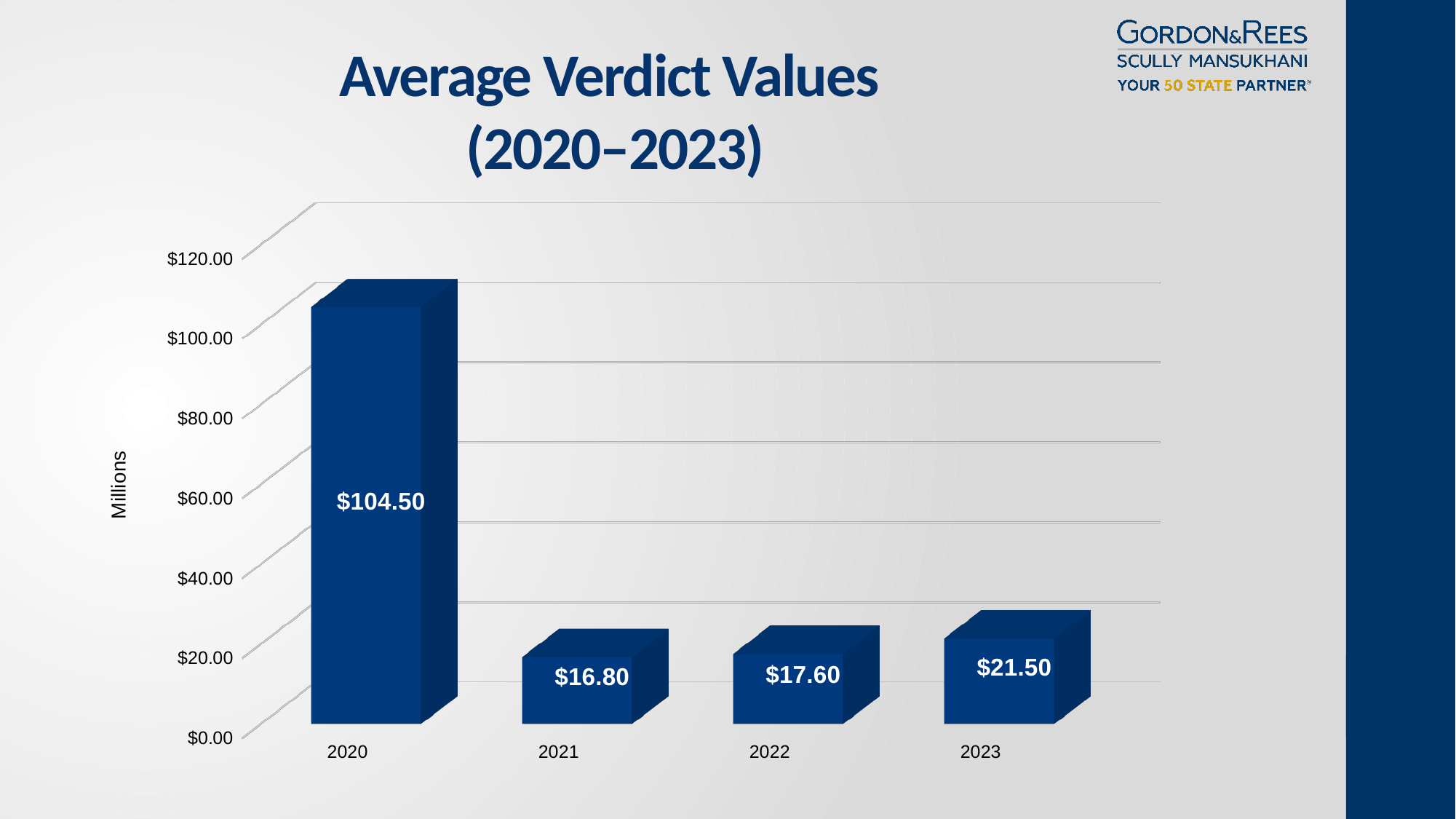
What is the label on the vertical axis of the chart? Millions Which year has the highest average verdict value? 2020 What is the average verdict value for 2023? $21.50 Which year has the lowest average verdict value? 2021 What is the average verdict value for 2020? $104.50 What kind of chart is shown on the slide? Bar chart Which year has a larger average verdict value, 2022 or 2023? 2023 What is the difference between the average verdict values for 2023 and 2021? $4.70 What is the average verdict value for 2022? $17.60 What is the average verdict value for 2021? $16.80 What is the difference between the average verdict values for 2020 and 2023? $83.00 How many years are shown on the chart? 4